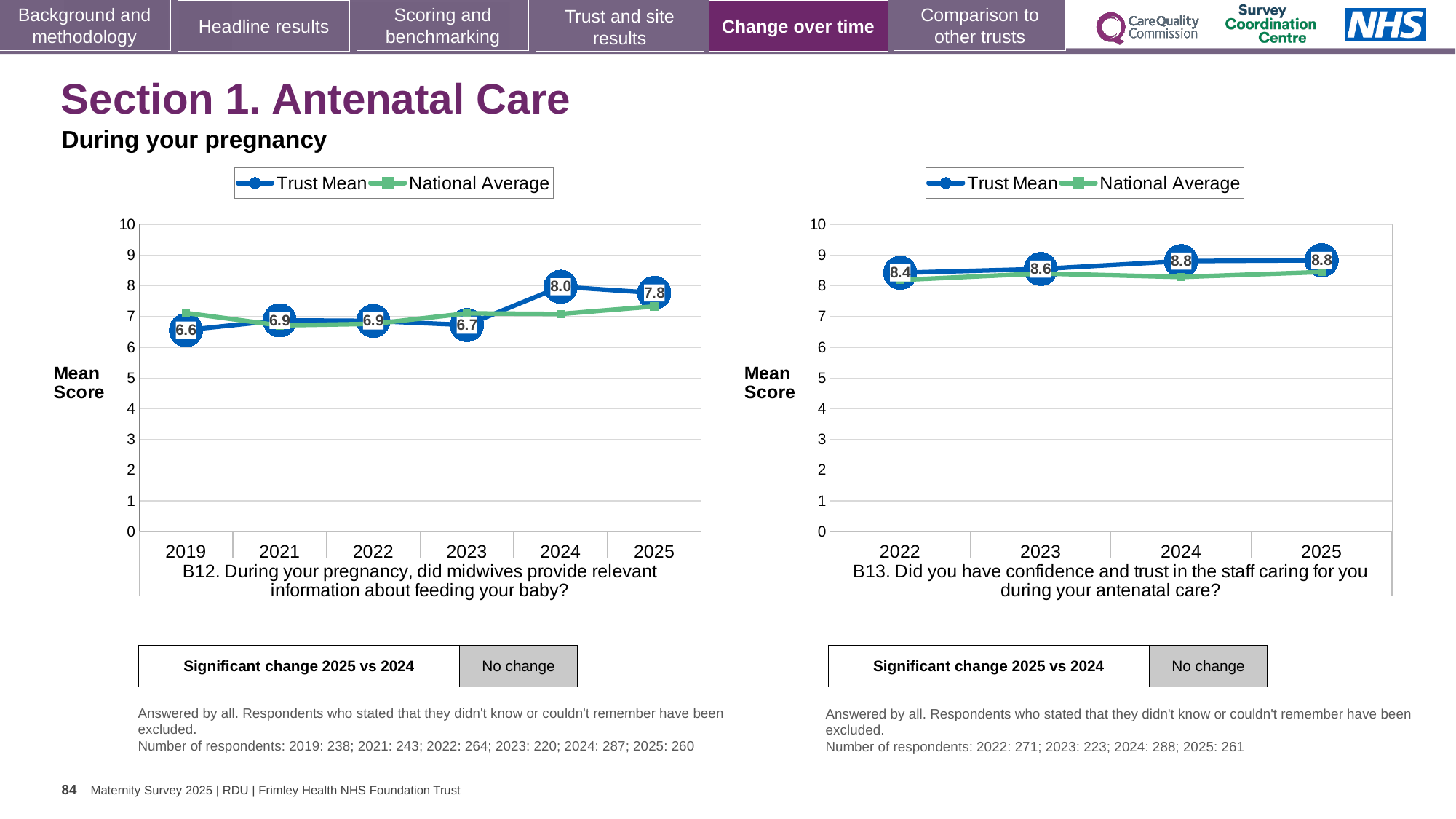
In the B12 chart (left), which is larger: the Trust Mean for 2024 or the Trust Mean for 2025? 2024 In the B13 chart (right), does the Trust Mean generally rise or fall from 2022 to 2025? Rise What kind of chart is the B13 chart (right)? Line chart How many years are plotted on the x axis of the B12 chart (left)? 6 In the B12 chart (left), which year has the highest Trust Mean? 2024 In the B13 chart (right), what is the Trust Mean for 2023? 8.6 How many series does the legend of the B13 chart (right) list? 2 In the B12 chart (left), which year has the lowest Trust Mean? 2019 In the B13 chart (right), is the National Average for 2022 greater or less than 9? less In the B13 chart (right), what is the difference between the Trust Mean for 2025 and the Trust Mean for 2022? 0.4 In the B12 chart (left), what is the Trust Mean for 2024? 8.0 In the B12 chart (left), what is the Trust Mean for 2019? 6.6